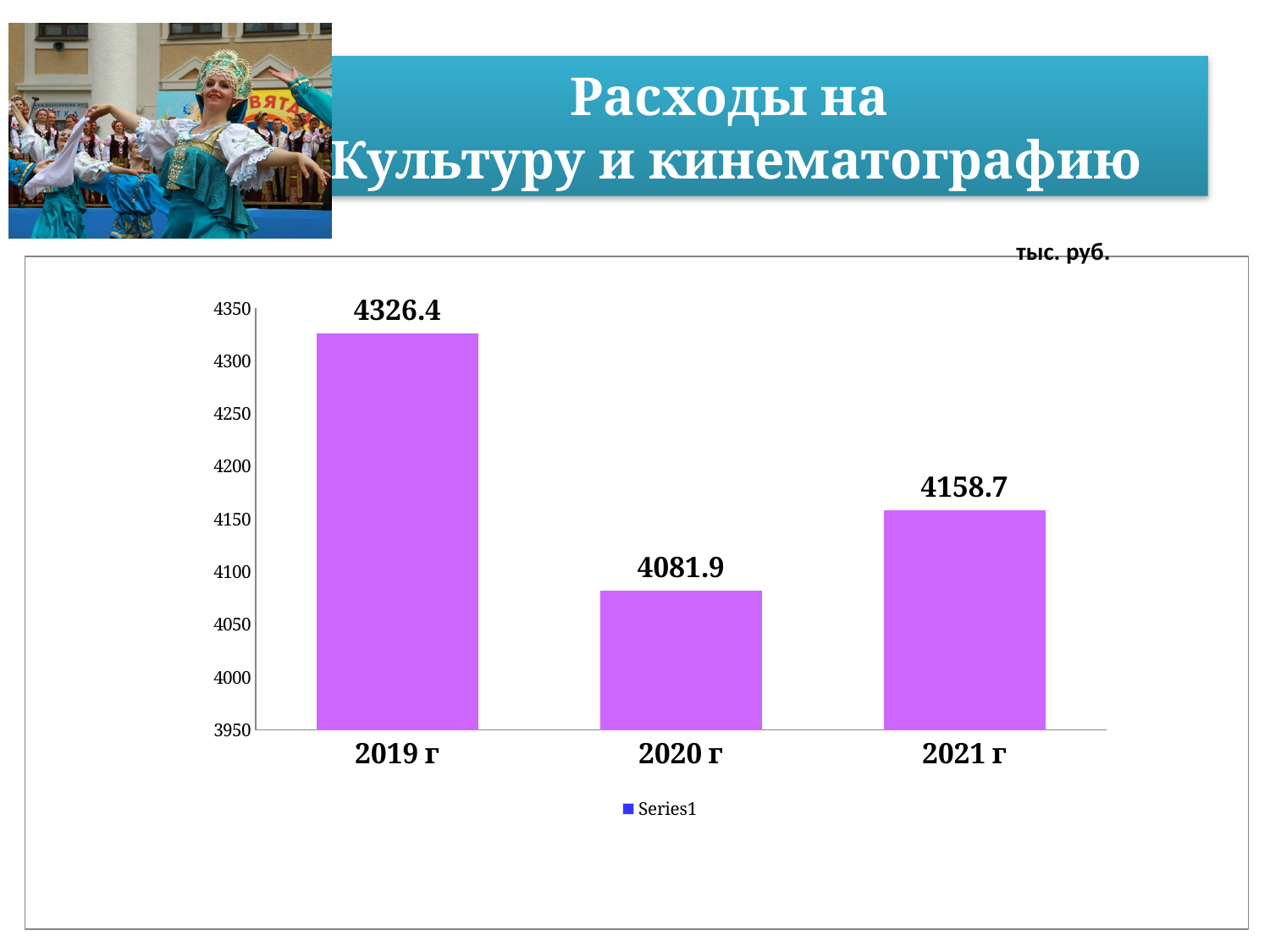
Which year has the highest value? 2019 г Which is larger, the value for 2021 г or the value for 2020 г? 2021 г Is the value for 2021 г greater or less than 4200? less What is the value for 2019 г? 4326.4 How many years are shown on the chart? 3 What is the difference between the values for 2021 г and 2020 г? 76.8 What is the value for 2021 г? 4158.7 What kind of chart is shown on the slide? bar chart What is the value for 2020 г? 4081.9 Which year has the lowest value? 2020 г What is the difference between the values for 2019 г and 2020 г? 244.5 What unit is indicated above the chart? тыс. руб.